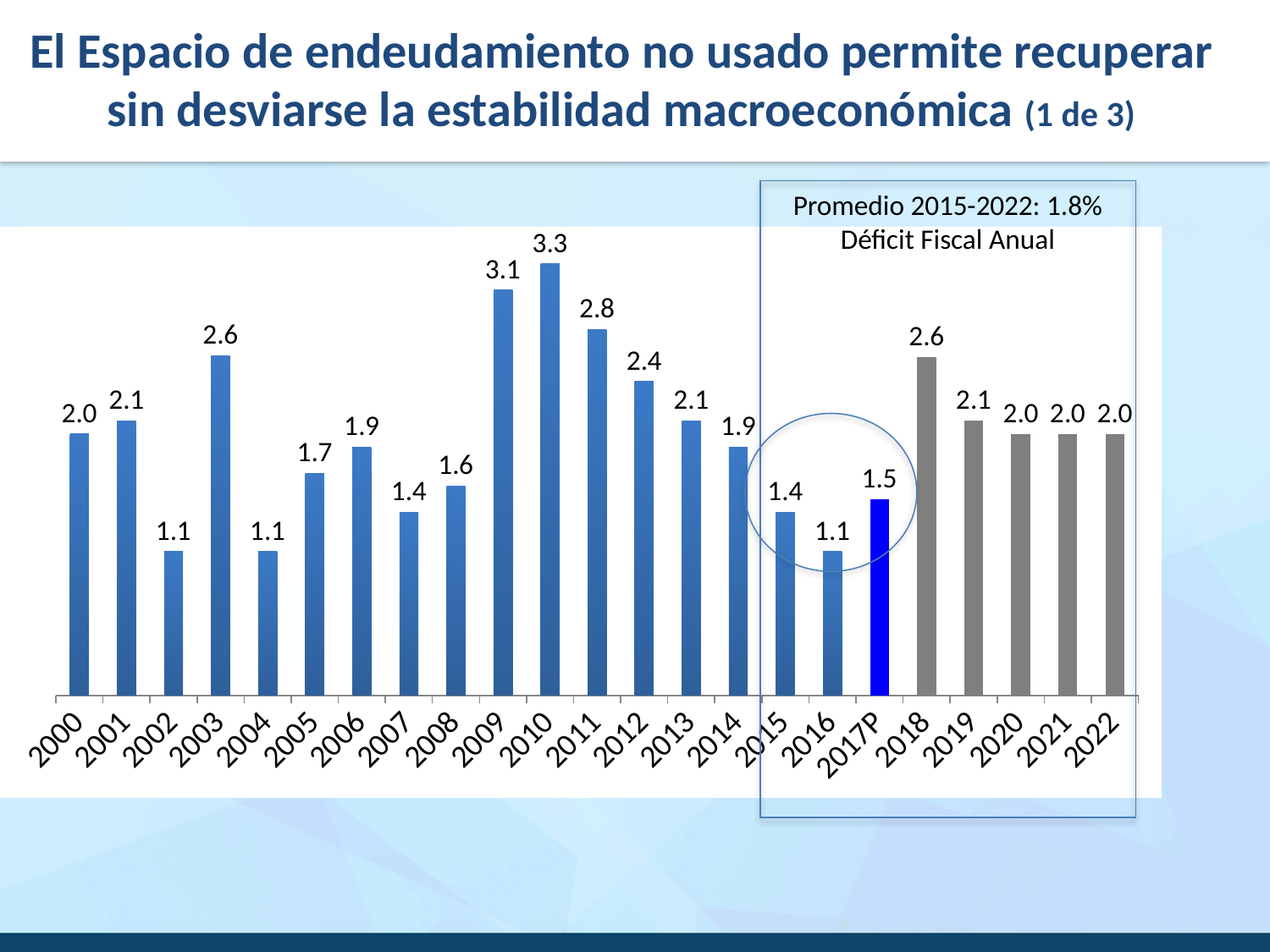
What is the difference between the values for 2010 and 2009? 0.2 What is the value shown for 2017P? 1.5 Which year has the highest value in the chart? 2010 Which is larger, the value for 2011 or the value for 2012? 2011 What is the value shown for 2010? 3.3 What average for 2015-2022 is stated in the box on the chart? 1.8% What is the value shown for 2003? 2.6 Which is larger, the value for 2015 or the value for 2016? 2015 What is the difference between the values for 2018 and 2017P? 1.1 How many bars (years) are plotted in the chart? 23 What kind of chart is shown on the slide? Bar chart What is the value shown for 2016? 1.1